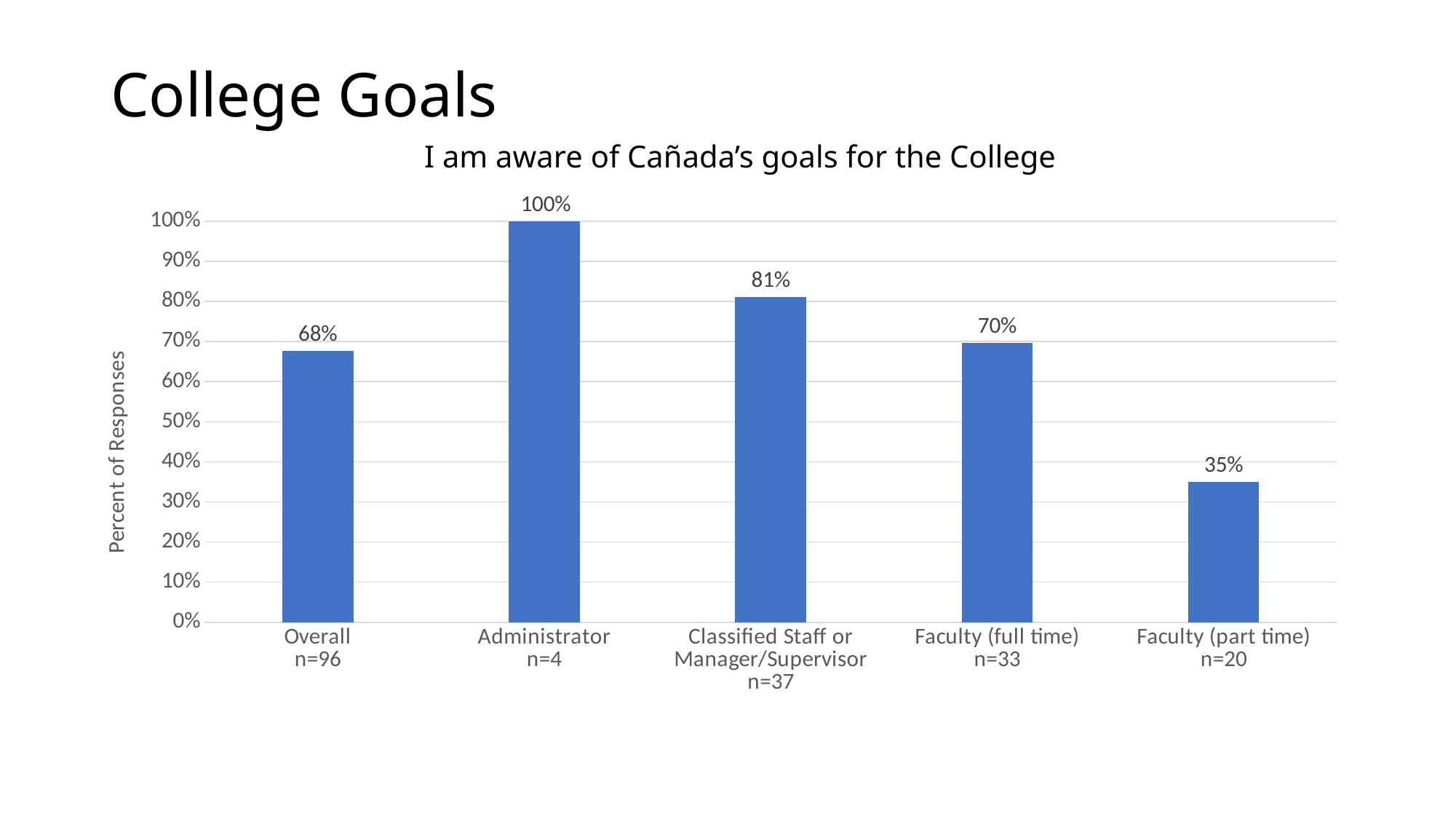
What is the value for Classified Staff or Manager/Supervisor? 81% What is the value for Faculty (part time)? 35% What is the value for Administrator? 100% Which category has the lowest value? Faculty (part time) Which is larger, the value for Faculty (full time) or the Overall value? Faculty (full time) How many categories are shown on the chart? 5 What is the Overall value? 68% What is the difference between the values for Classified Staff or Manager/Supervisor and Faculty (full time)? 11% What kind of chart is shown? Bar chart What is the title of the chart? I am aware of Cañada's goals for the College Which category has the highest value? Administrator What is the difference between the values for Administrator and Faculty (part time)? 65%